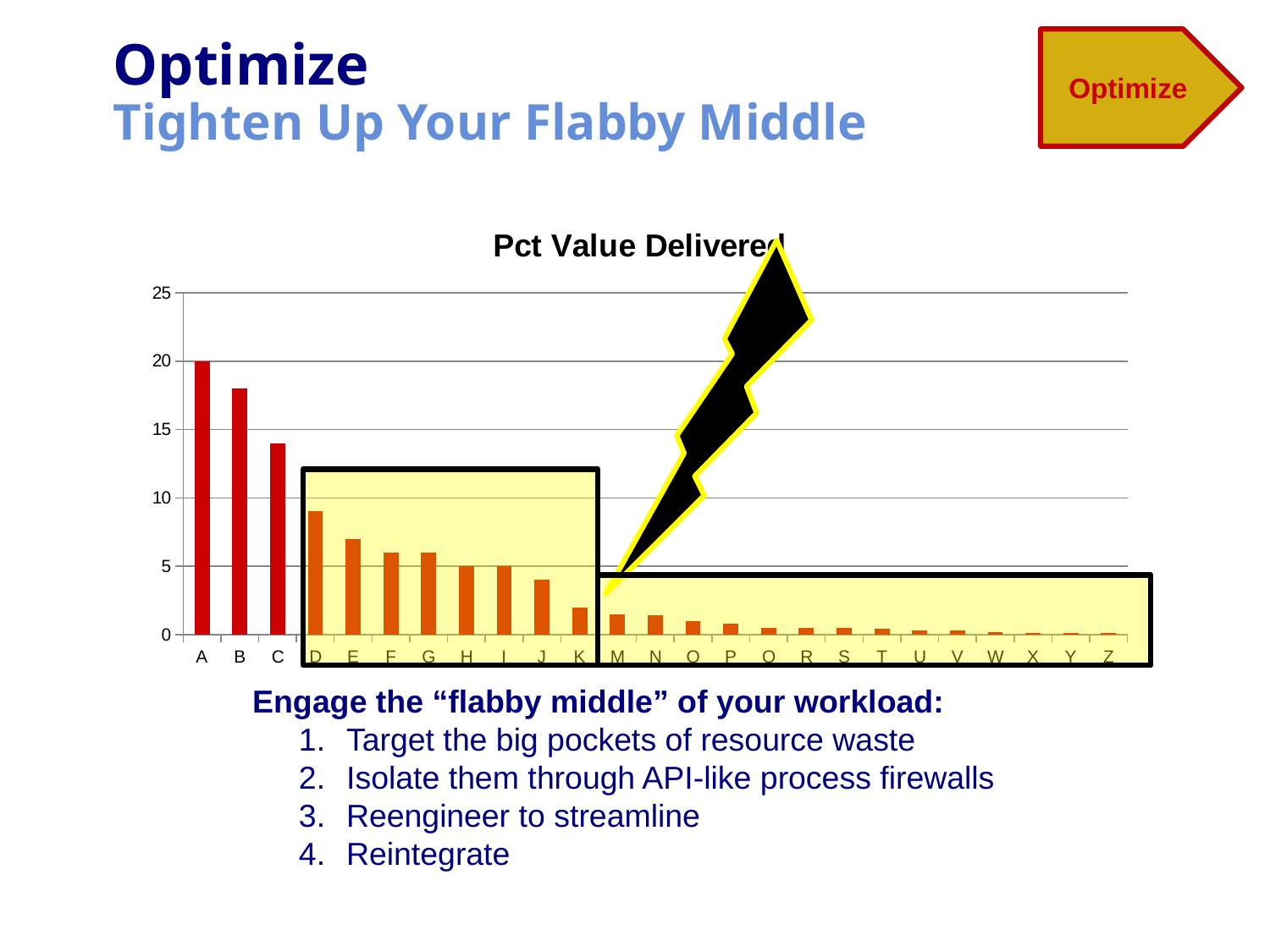
What is the title of the chart? Pct Value Delivered Is the value for C greater or less than 15? less Is the value for D greater or less than 10? less Do the values rise or fall moving from left to right along the x axis? fall What kind of chart is shown on the slide? bar chart Is the value for B greater or less than 15? greater What is the value for category A? 20 Which category has the highest value in the chart? A Which is larger, the value for D or the value for K? D Which is larger, the value for A or the value for C? A